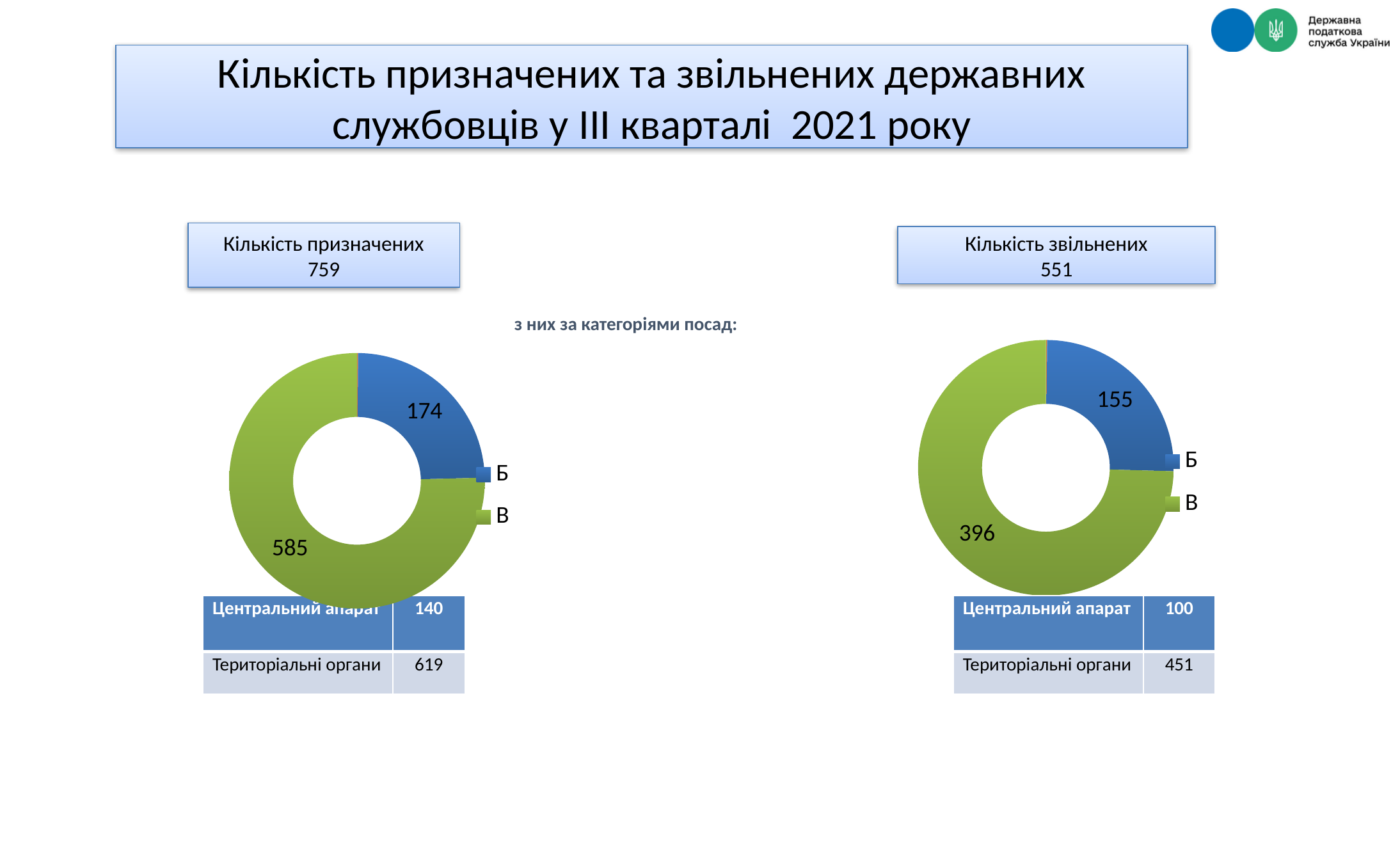
What type of chart is used on the left side of the slide (Кількість призначених)? Doughnut chart In the left chart (Кількість призначених), what is the difference between the values for В and Б? 411 In the right chart (Кількість звільнених), which category has the smallest value? Б In the left chart (Кількість призначених), what is the value for category В? 585 In the left chart (Кількість призначених), which category has the largest value? В In the right chart (Кількість звільнених), what is the difference between the values for В and Б? 241 In the right chart (Кількість звільнених), what is the value for category Б? 155 Which is larger: the value for Б in the left chart (Кількість призначених) or the value for Б in the right chart (Кількість звільнених)? Left chart (174) In the right chart (Кількість звільнених), what is the value for category В? 396 What total is shown in the box above the left chart (Кількість призначених)? 759 How many entries does the legend of the right chart (Кількість звільнених) list? 2 In the left chart (Кількість призначених), what is the value for category Б? 174